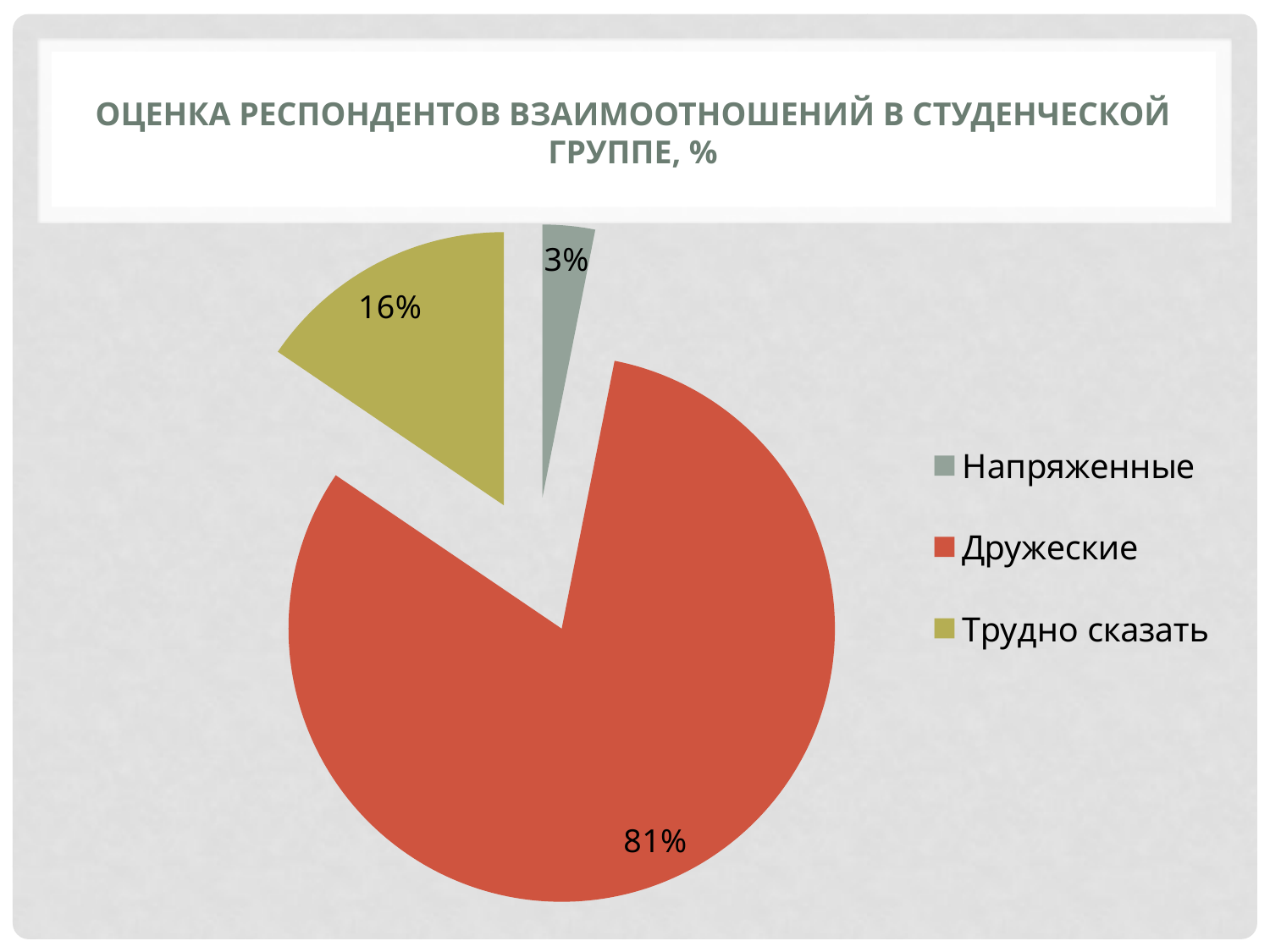
What is the difference in percentage points between Дружеские and Трудно сказать? 65 What share of respondents rated relationships as Напряженные? 3% What share of respondents rated relationships as Дружеские? 81% Which category has the largest share of the pie? Дружеские Which is larger, the share for Трудно сказать or the share for Напряженные? Трудно сказать What share of respondents answered Трудно сказать? 16% What kind of chart is shown on the slide? pie chart How many categories does the pie chart have? 3 What colour is the slice for Дружеские? red What is the difference in percentage points between Трудно сказать and Напряженные? 13 What is the title of the chart? Оценка респондентов взаимоотношений в студенческой группе, % Which category has the smallest share of the pie? Напряженные